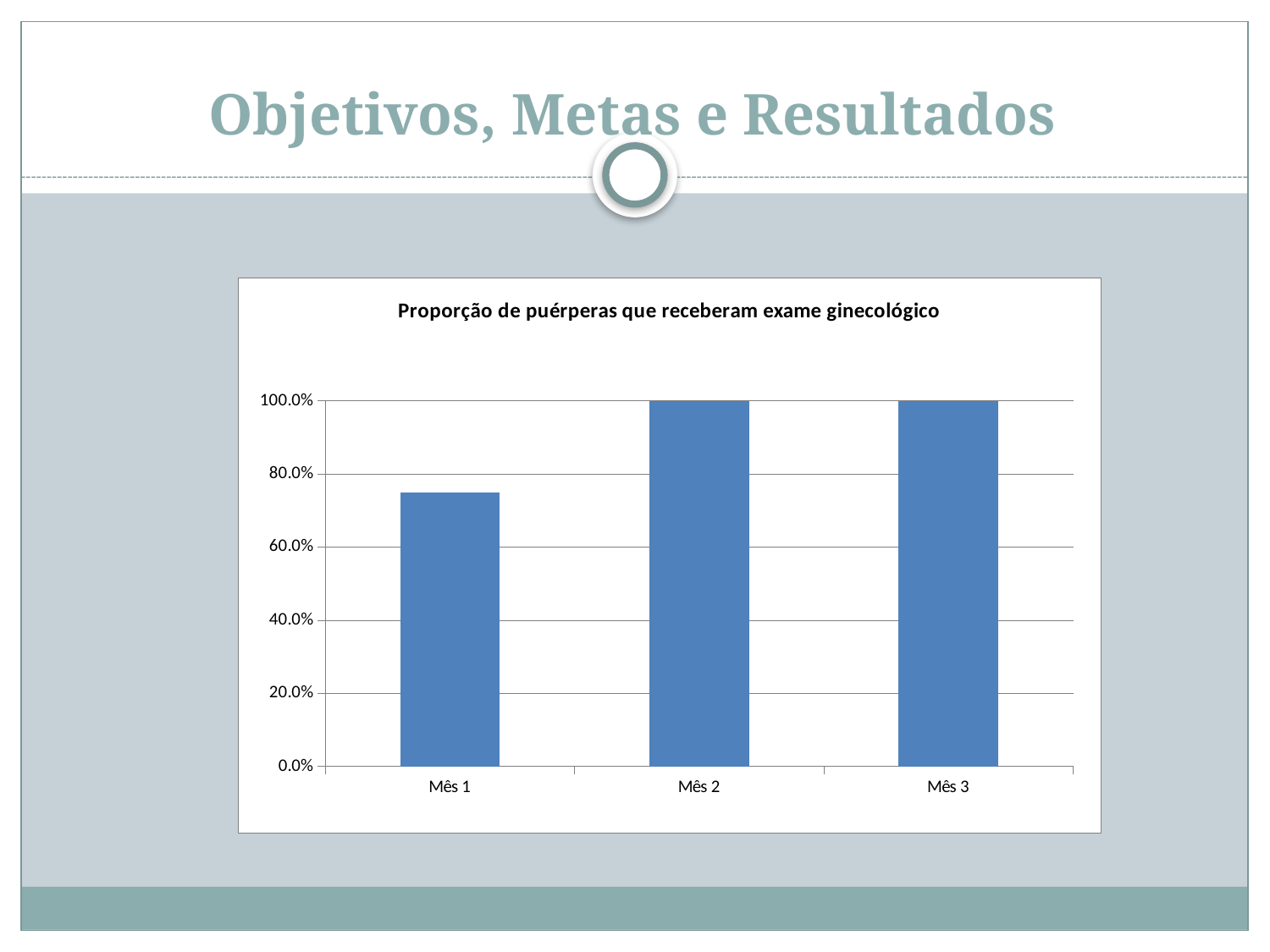
What is the difference between the values for Mês 2 and Mês 3? 0.0% What is the value for Mês 2? 100.0% Do the values rise or fall from Mês 1 to Mês 2? rise What is the highest value shown on the y axis? 100.0% What is the title of the chart? Proporção de puérperas que receberam exame ginecológico Is the value for Mês 1 greater or less than 60.0%? greater What is the value for Mês 3? 100.0% What kind of chart is shown on the slide? bar chart Which is larger, the value for Mês 1 or the value for Mês 2? Mês 2 How many categories are shown on the x axis? 3 Which month has the lowest value? Mês 1 Is the value for Mês 1 greater or less than 80.0%? less